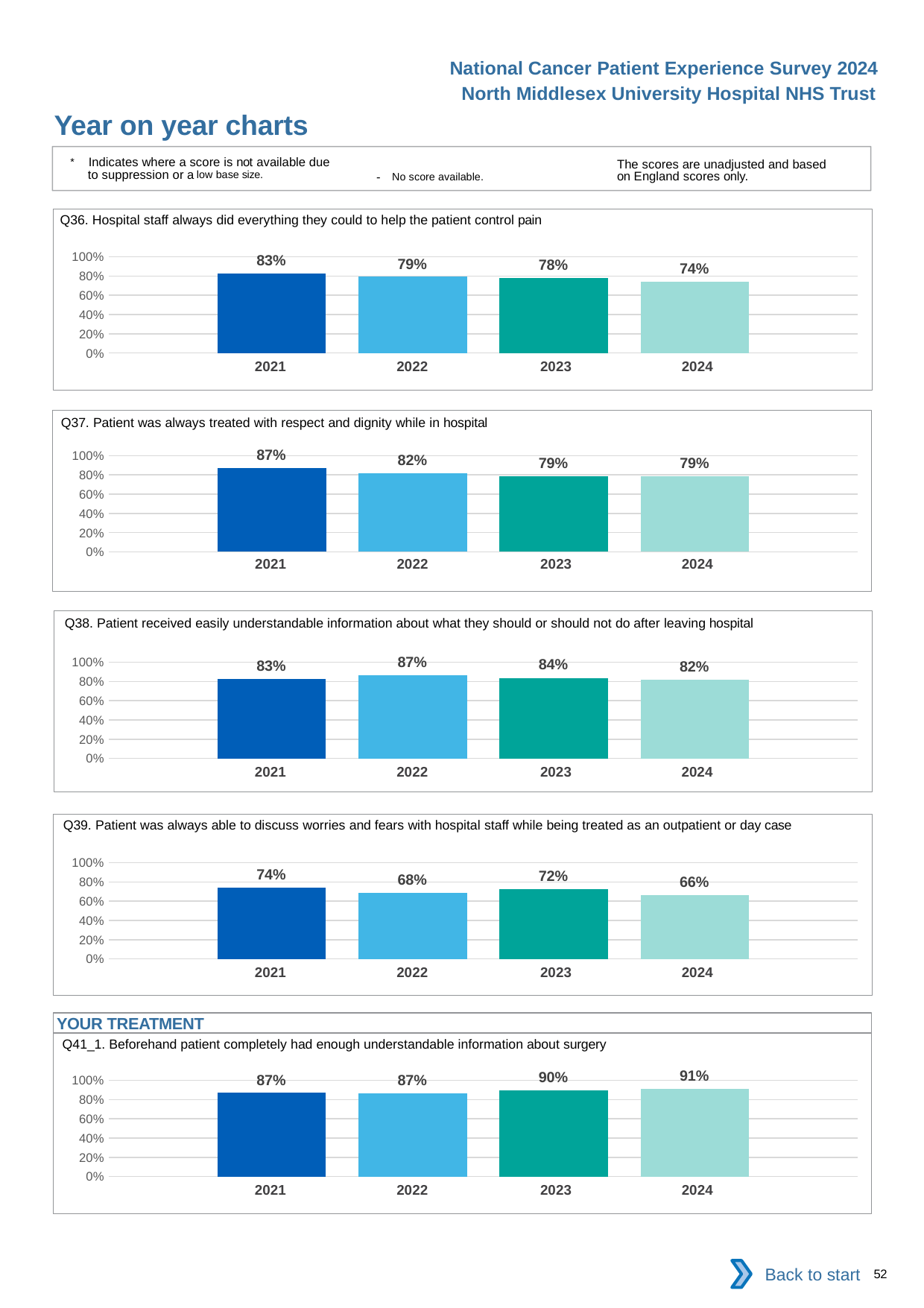
In the Q41_1 chart, what is the value for 2023? 90% In the Q37 chart (patient was always treated with respect and dignity while in hospital), what is the value for 2022? 82% How many years are plotted in the Q36 chart? 4 In the Q38 chart, what is the value for 2024? 82% In the Q38 chart (patient received easily understandable information about what they should or should not do after leaving hospital), which year has the highest value? 2022 In the Q39 chart, what is the value for 2024? 66% In the Q36 chart (hospital staff always did everything they could to help the patient control pain), what is the value for 2021? 83% In the Q36 chart, which year has the lowest value? 2024 In the Q37 chart, what is the difference between the 2021 and 2024 values? 8 percentage points In the Q41_1 chart (beforehand patient completely had enough understandable information about surgery), do the values rise or fall from 2021 to 2024? rise What kind of chart is used for Q37? bar chart In the Q39 chart (patient was always able to discuss worries and fears with hospital staff), which is larger, the value for 2022 or the value for 2023? 2023